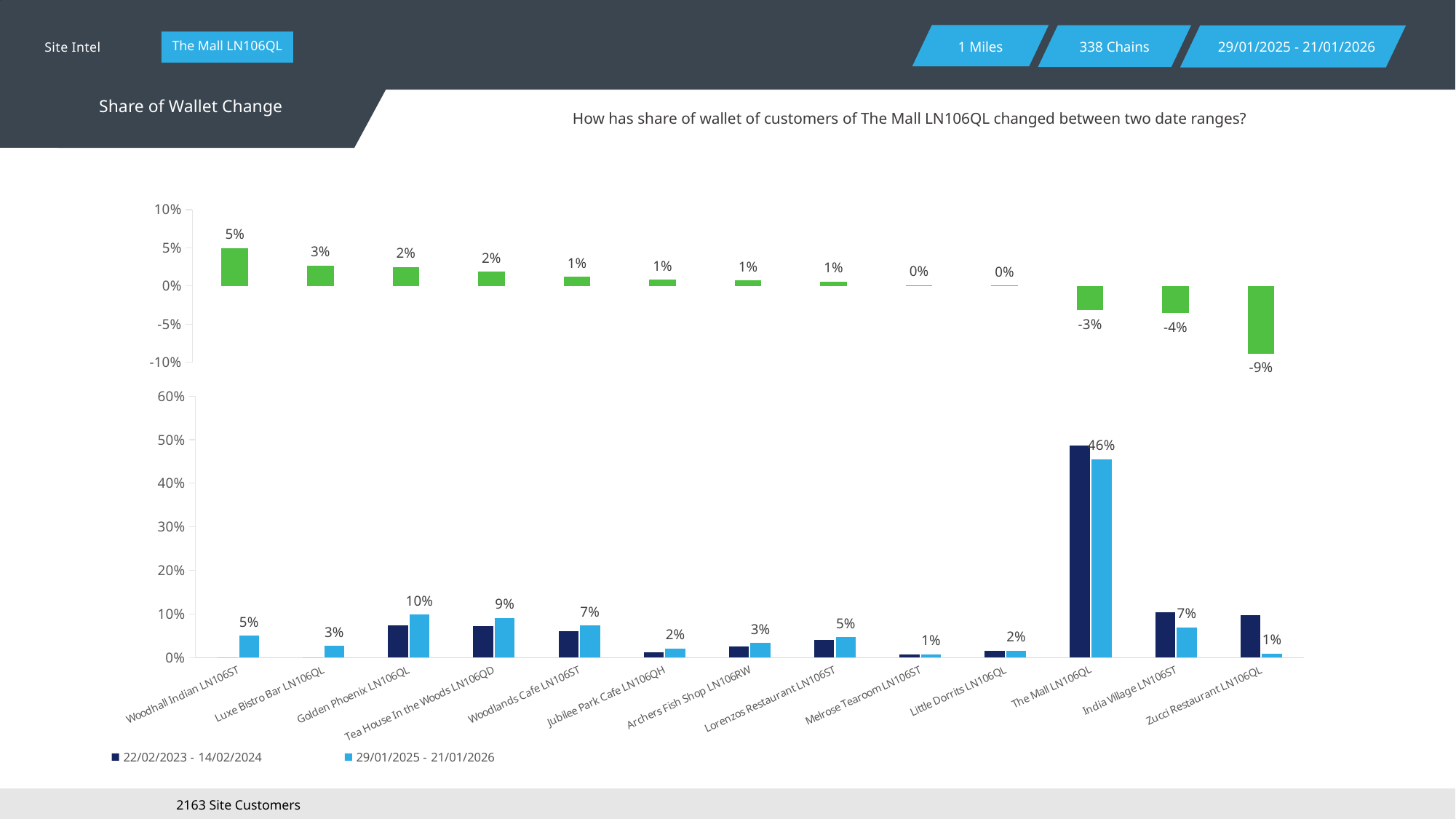
In the bottom chart, what is the difference between Golden Phoenix LN106QL and Tea House In the Woods LN106QD in the 29/01/2025 - 21/01/2026 series? 1% How many series does the legend of the bottom chart list? 2 In the top chart, which category has the highest value? Woodhall Indian LN106ST In the bottom chart, what is the value for The Mall LN106QL in the 29/01/2025 - 21/01/2026 series? 46% What kind of chart is the bottom chart? bar chart In the top chart, do the values rise or fall from left to right along the x axis? fall How many categories are shown on the x axis of the bottom chart? 13 In the top chart, which category has the lowest value? Zucci Restaurant LN106QL In the top chart (Share of Wallet Change), what is the value for Woodhall Indian LN106ST? 5% In the top chart, what is the value for India Village LN106ST? -4% In the bottom chart, which is larger in the 29/01/2025 - 21/01/2026 series: Woodlands Cafe LN106ST or Jubilee Park Cafe LN106QH? Woodlands Cafe LN106ST In the bottom chart, is the value for The Mall LN106QL in the 22/02/2023 - 14/02/2024 series greater or less than 40%? greater